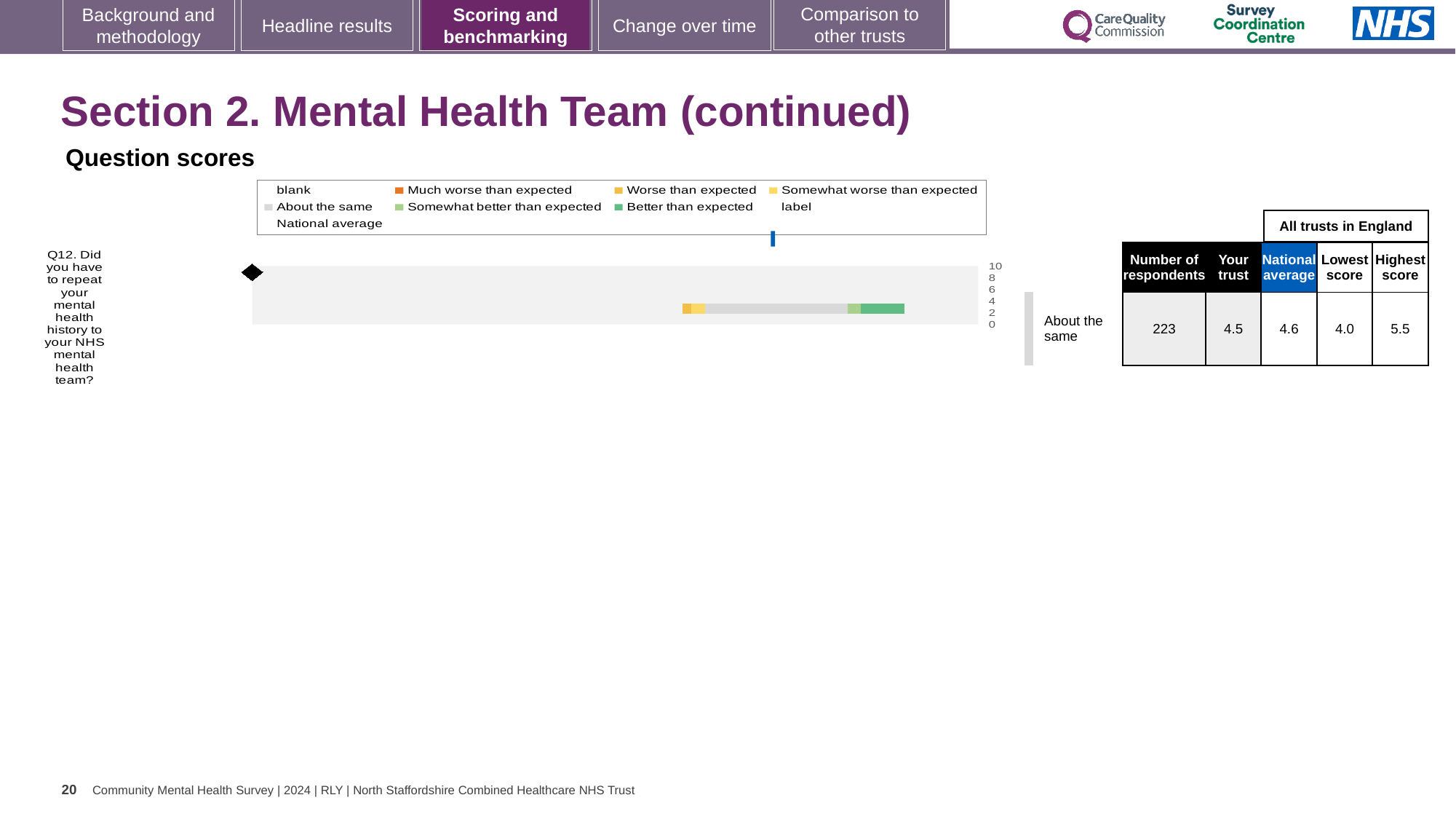
Which benchmark category is shown for Q12 next to the chart? About the same What is the difference between the highest score and the lowest score for Q12? 1.5 What is the 'Your trust' score for Q12? 4.5 What is the lowest score among all trusts in England for Q12? 4.0 What is the number of respondents for Q12? 223 How many entries does the chart legend list? 9 What is the national average score for Q12? 4.6 What kind of chart is shown on the slide? bar chart Which is larger for Q12, the 'Your trust' score or the national average? National average What is the highest score among all trusts in England for Q12? 5.5 What colour represents 'Better than expected' in the chart legend? green How many survey questions are plotted in the chart? 1